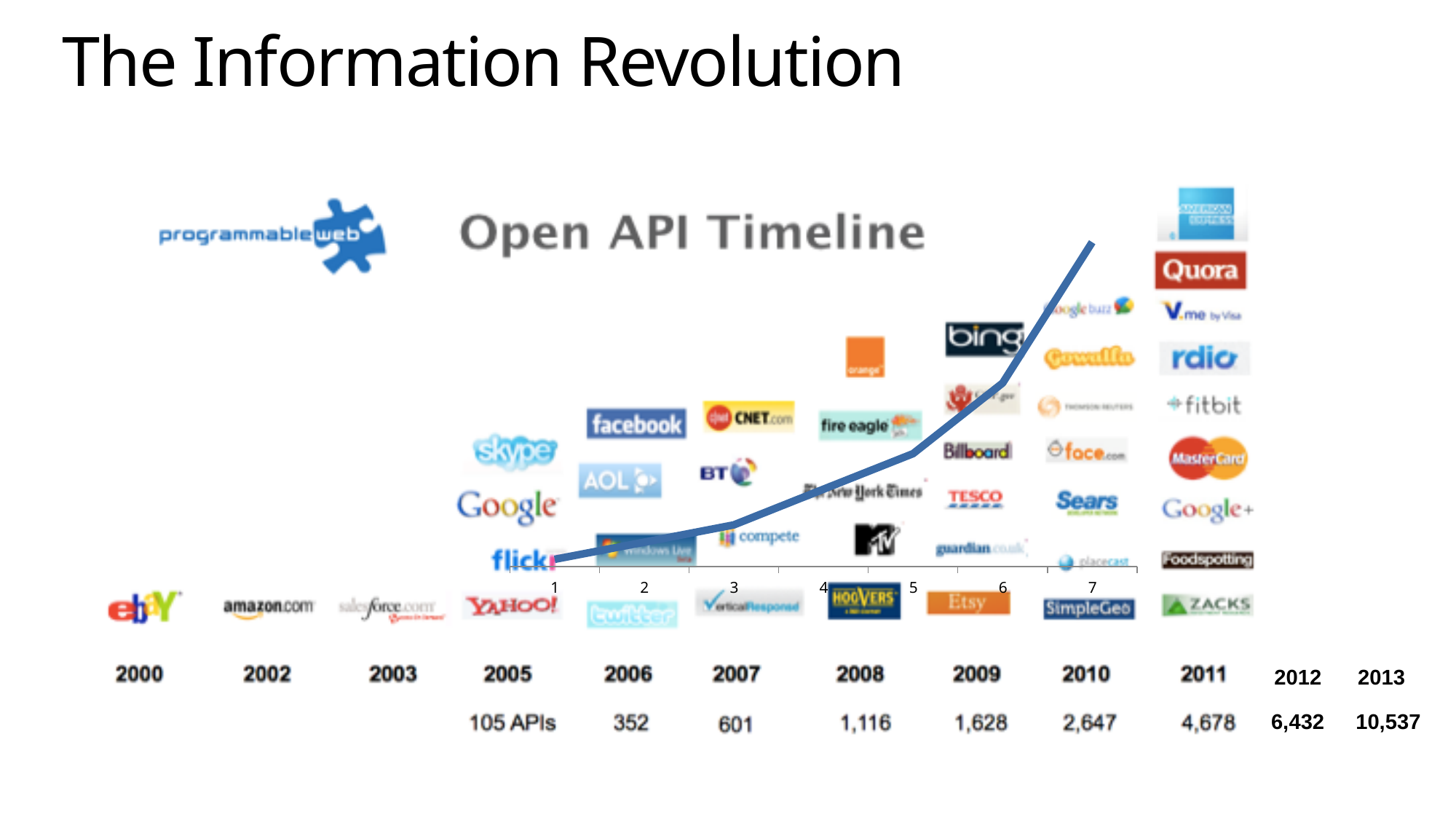
What is the API count shown for 2013? 10,537 Which year has the larger API count, 2010 or 2011? 2011 Which year has the highest API count shown on the slide? 2013 What kind of chart is overlaid on the Open API Timeline image? line chart How many numbered points are marked along the x axis of the line chart? 7 What is the API count shown for 2009? 1,628 What is the title shown on the timeline image? Open API Timeline What is the difference between the API counts for 2013 and 2012? 4,105 What is the difference between the API counts for 2011 and 2010? 2,031 Which year has the lowest API count shown on the slide? 2005 How many APIs are listed for 2005? 105 APIs Does the line on the chart rise or fall from left to right? rise